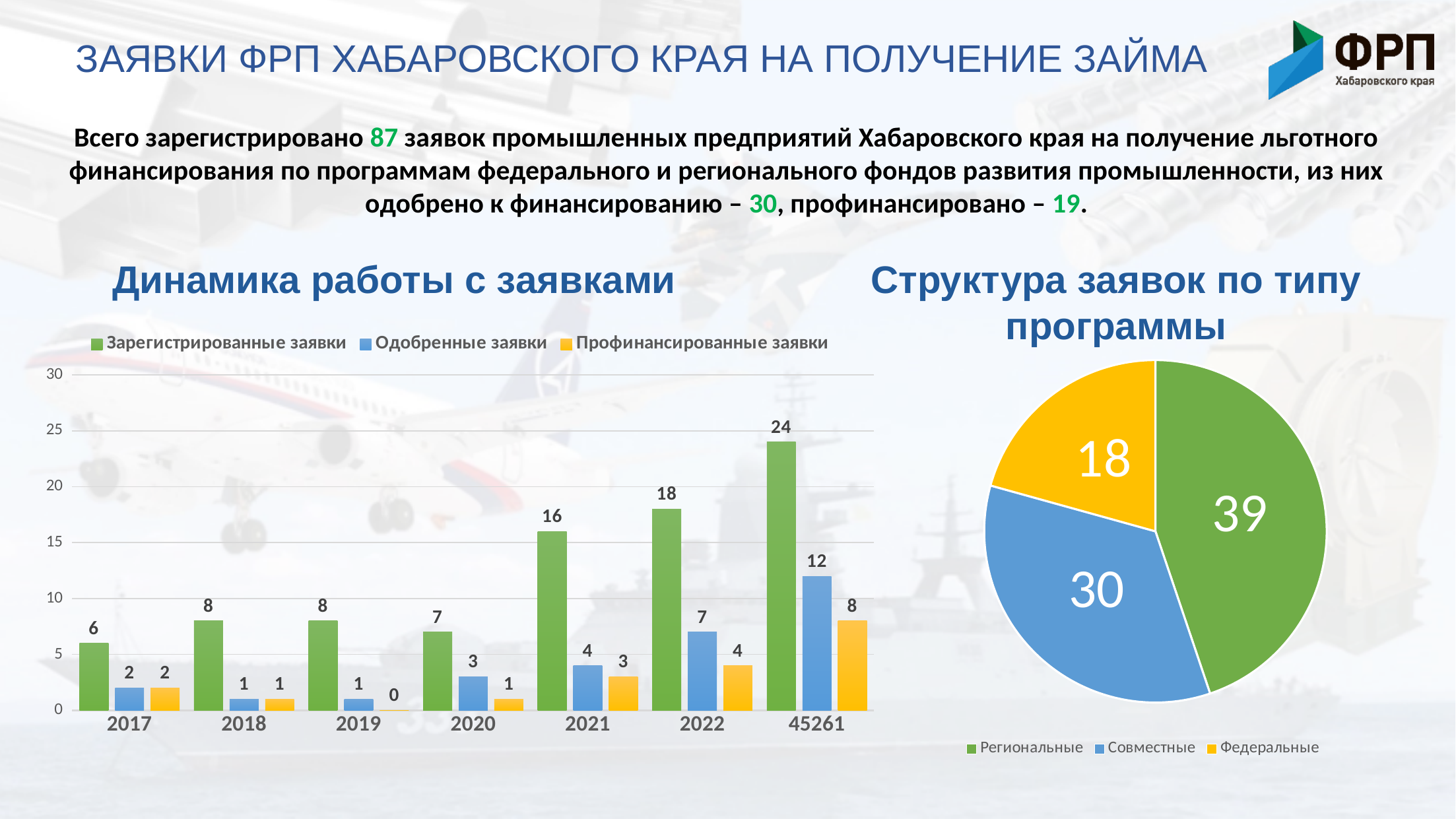
In the chart 'Динамика работы с заявками', which is larger: Одобренные заявки for 2021 or Одобренные заявки for 2022? 2022 In the pie chart 'Структура заявок по типу программы', what is the value for Совместные? 30 In the chart 'Динамика работы с заявками', what is the difference between Зарегистрированные заявки and Одобренные заявки for 2020? 4 In the chart 'Динамика работы с заявками', what is the value of Зарегистрированные заявки for 2021? 16 In the chart 'Динамика работы с заявками', what is the value of Одобренные заявки for 2022? 7 In the chart 'Динамика работы с заявками', which category has the highest value for Зарегистрированные заявки? 45261 What kind of chart is 'Динамика работы с заявками'? bar chart In the chart 'Динамика работы с заявками', which year has the lowest value for Зарегистрированные заявки? 2017 How many series does the legend of the chart 'Динамика работы с заявками' list? 3 In the pie chart 'Структура заявок по типу программы', what is the difference between Региональные and Федеральные? 21 In the chart 'Динамика работы с заявками', what is the value of Профинансированные заявки for 2019? 0 In the pie chart 'Структура заявок по типу программы', which category has the smallest slice? Федеральные